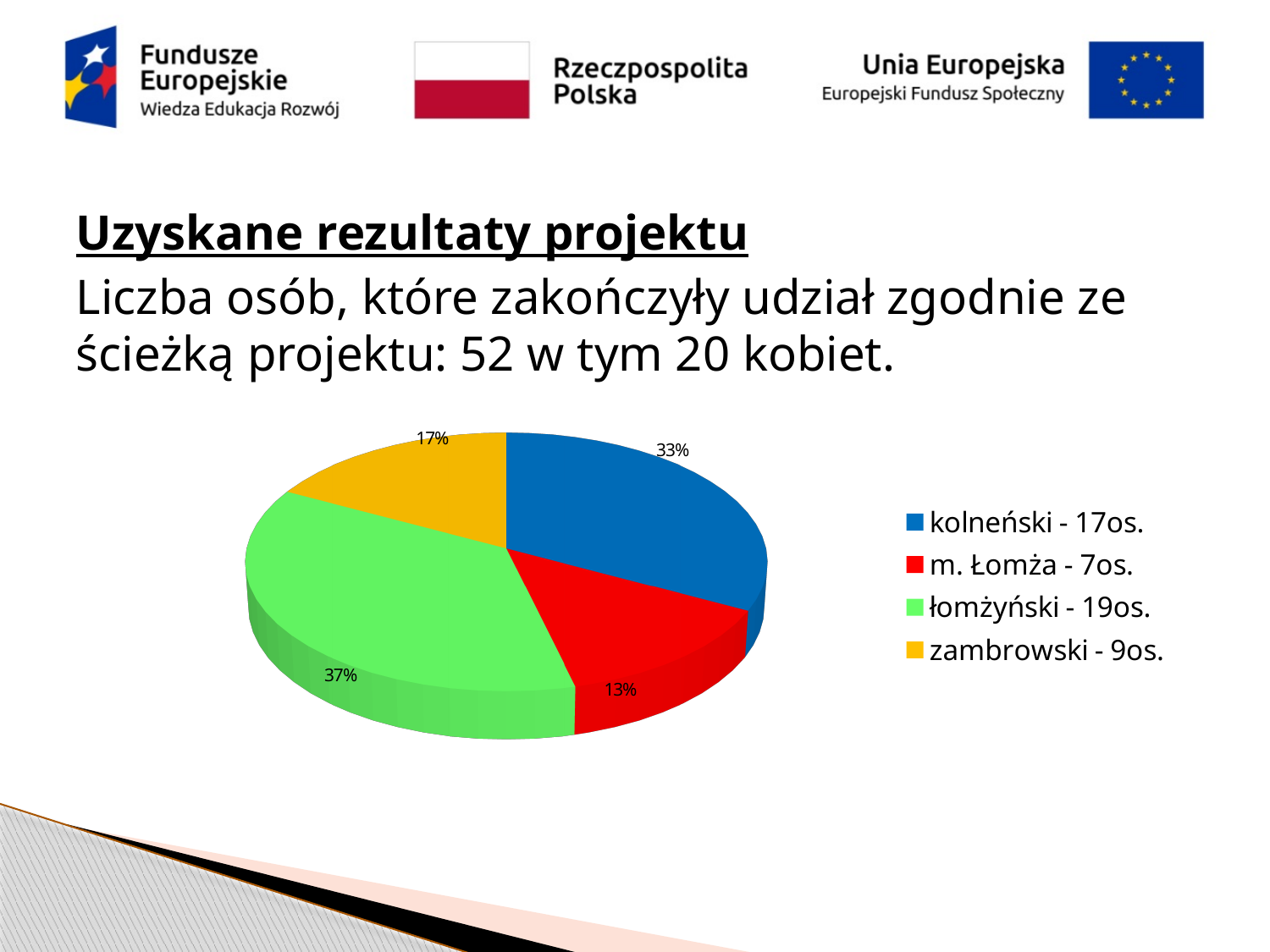
Which has a larger share, kolneński or zambrowski? kolneński Which category has the largest share of the pie? łomżyński How many slices does the pie chart have? 4 What percentage share does the kolneński slice have? 33% What colour is the zambrowski slice? yellow Which category has the smallest share of the pie? m. Łomża What is the difference in percentage points between the łomżyński and m. Łomża slices? 24 How many people does the legend give for the łomżyński category? 19os. What percentage share does the zambrowski slice have? 17% What percentage share does the łomżyński slice have? 37% What kind of chart is shown on the slide? pie chart